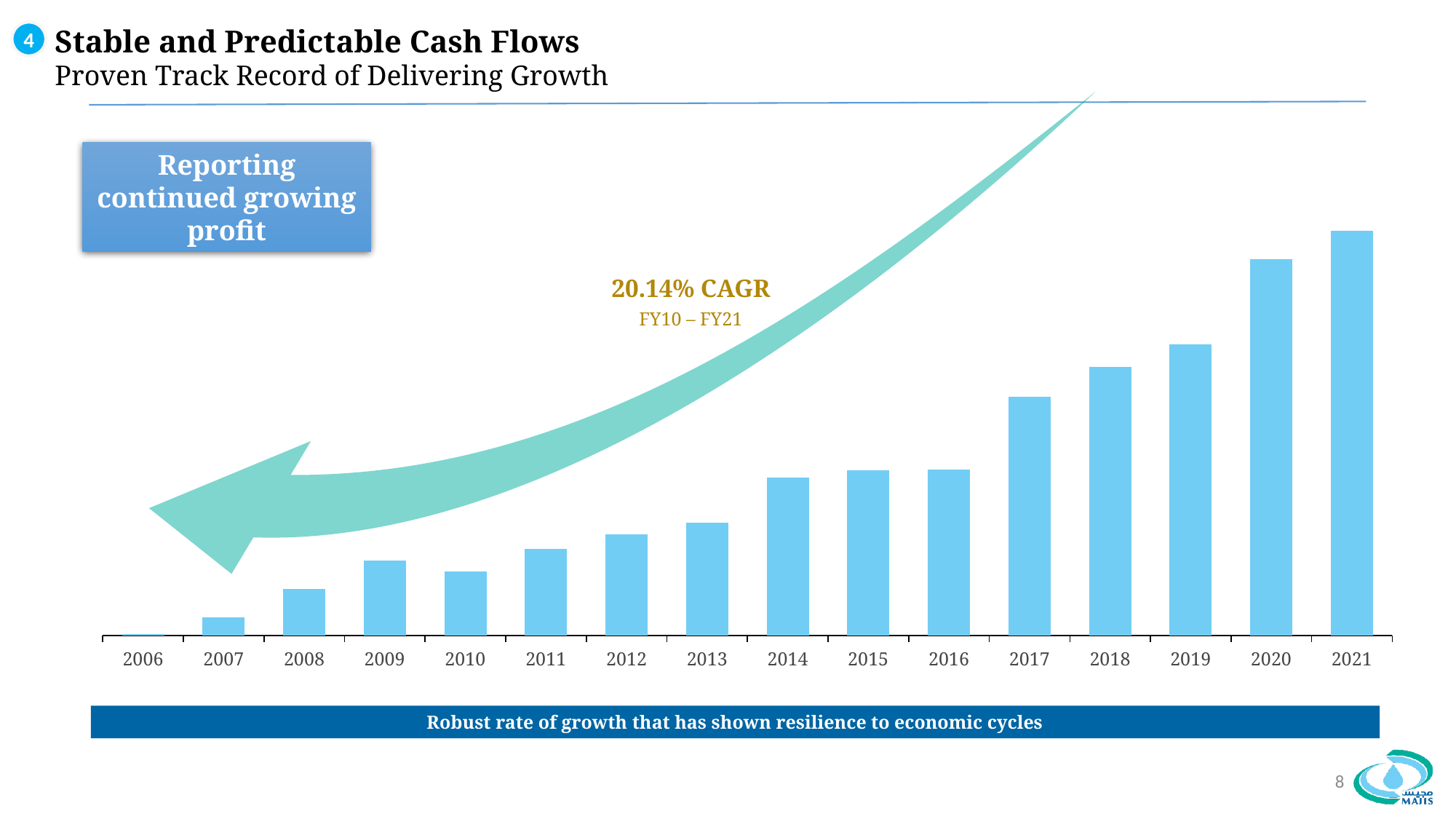
Which year has the shortest bar in the chart? 2006 How many years are shown on the x axis of the chart? 16 Which year has the larger value, 2017 or 2014? 2017 Which year has the larger value, 2020 or 2018? 2020 Which year has the tallest bar in the chart? 2021 Which year has the larger value, 2007 or 2012? 2012 What kind of chart is shown on the slide? Bar chart What CAGR figure is printed on the chart? 20.14% CAGR Do the bar values generally rise or fall from 2006 to 2021? Rise What is the first year shown on the x axis of the chart? 2006